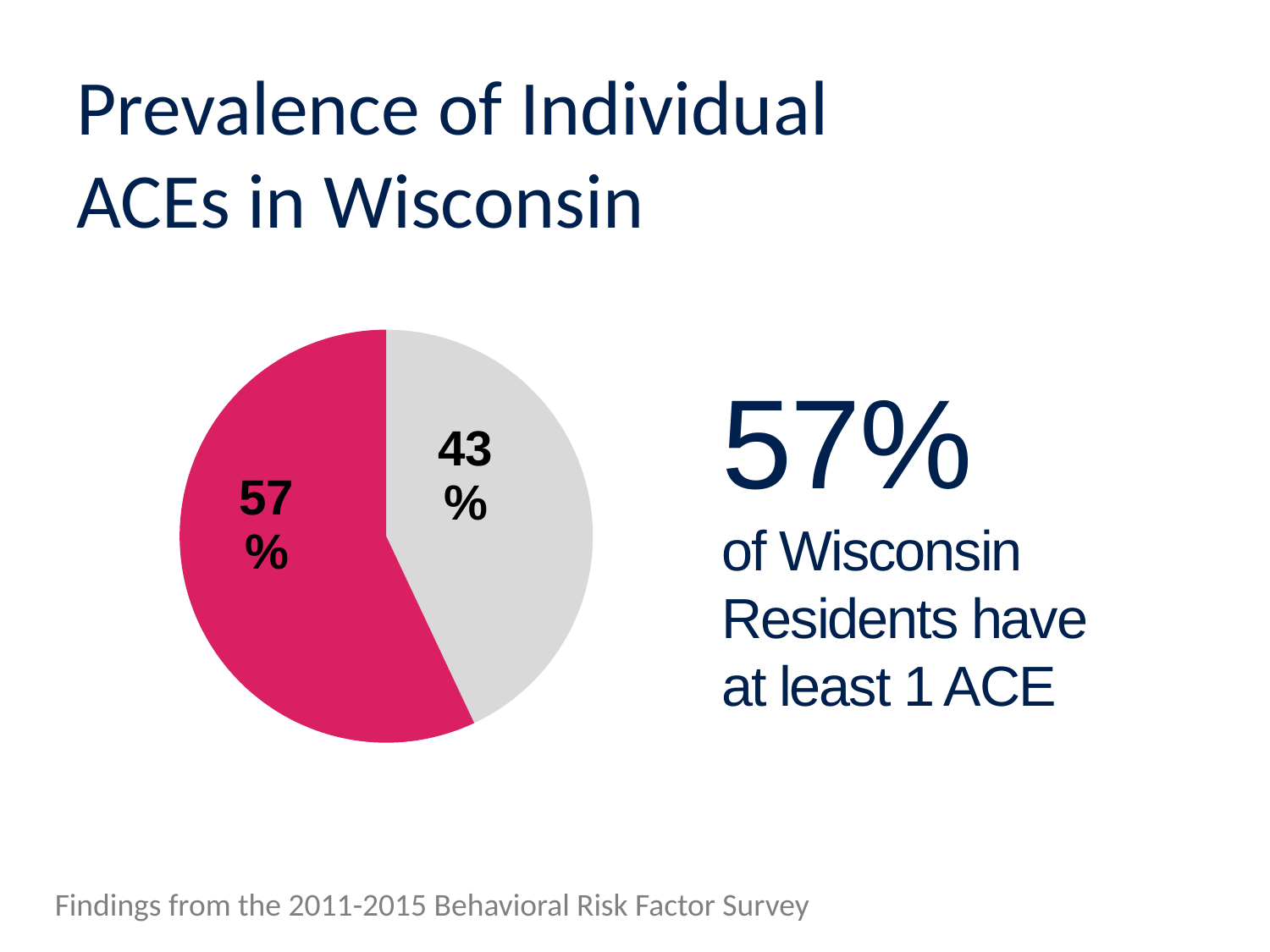
Which is larger, the pink slice or the gray slice? The pink slice Which slice of the pie chart is the largest? The pink slice (57%) Which slice of the pie chart is the smallest? The gray slice (43%) According to the slide, what percentage of Wisconsin residents have at least 1 ACE? 57% What kind of chart is shown on the slide? Pie chart What percentage is shown on the gray slice of the pie chart? 43% What share of the pie does the gray slice represent? 43% How many slices does the pie chart have? 2 What percentage is shown on the pink slice of the pie chart? 57% What is the title of the slide containing the pie chart? Prevalence of Individual ACEs in Wisconsin Is the pink slice greater or less than 50% of the pie? greater What is the difference in percentage points between the pink slice and the gray slice? 14 percentage points